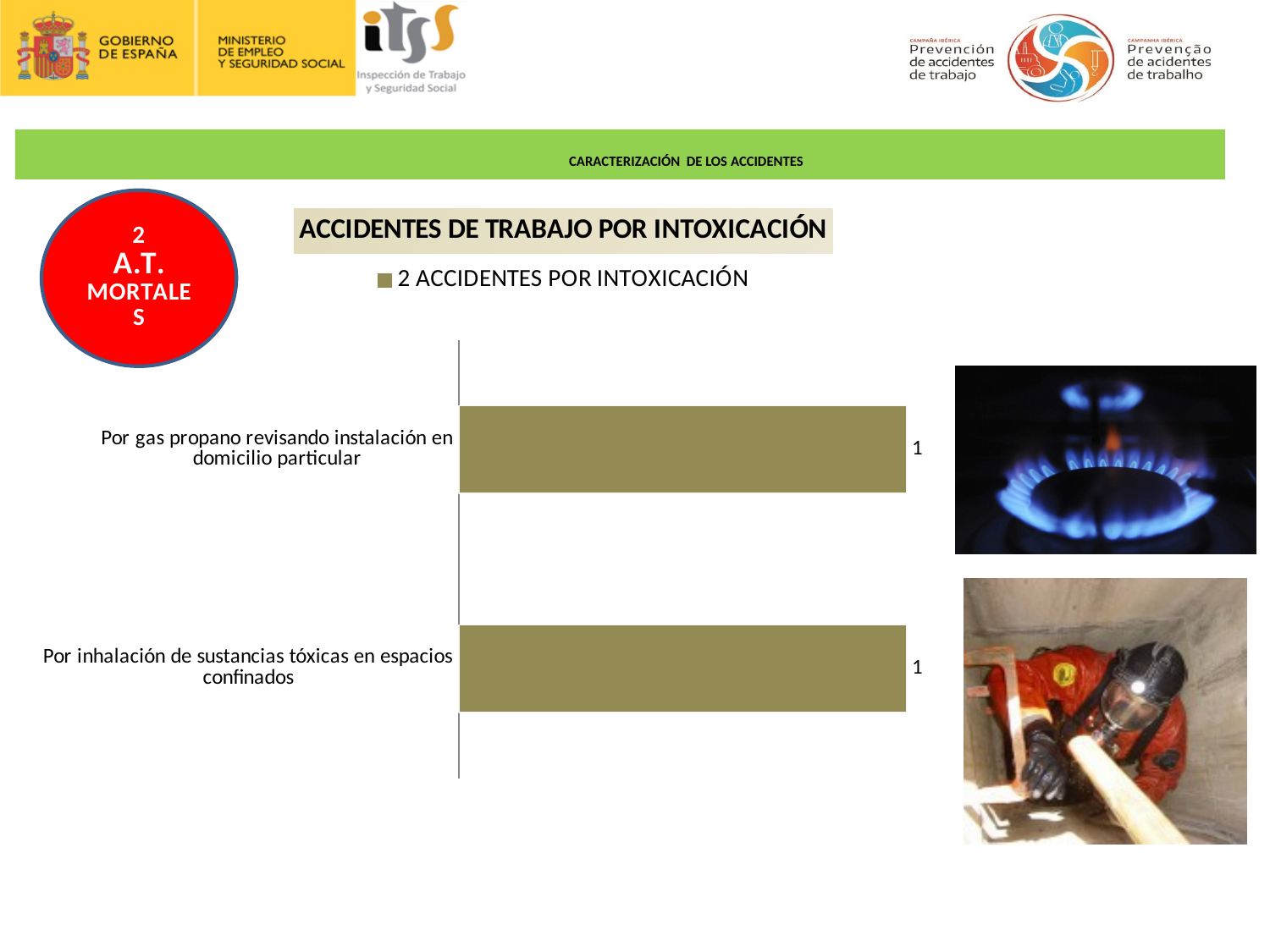
What kind of chart is shown on the slide? bar chart What is the value for "Por inhalación de sustancias tóxicas en espacios confinados"? 1 What is the title of the chart? ACCIDENTES DE TRABAJO POR INTOXICACIÓN What is the legend entry of the chart? 2 ACCIDENTES POR INTOXICACIÓN What is the value for "Por gas propano revisando instalación en domicilio particular"? 1 How many categories are shown in the chart? 2 What is the difference between the value for "Por gas propano revisando instalación en domicilio particular" and the value for "Por inhalación de sustancias tóxicas en espacios confinados"? 0 How many series does the legend list? 1